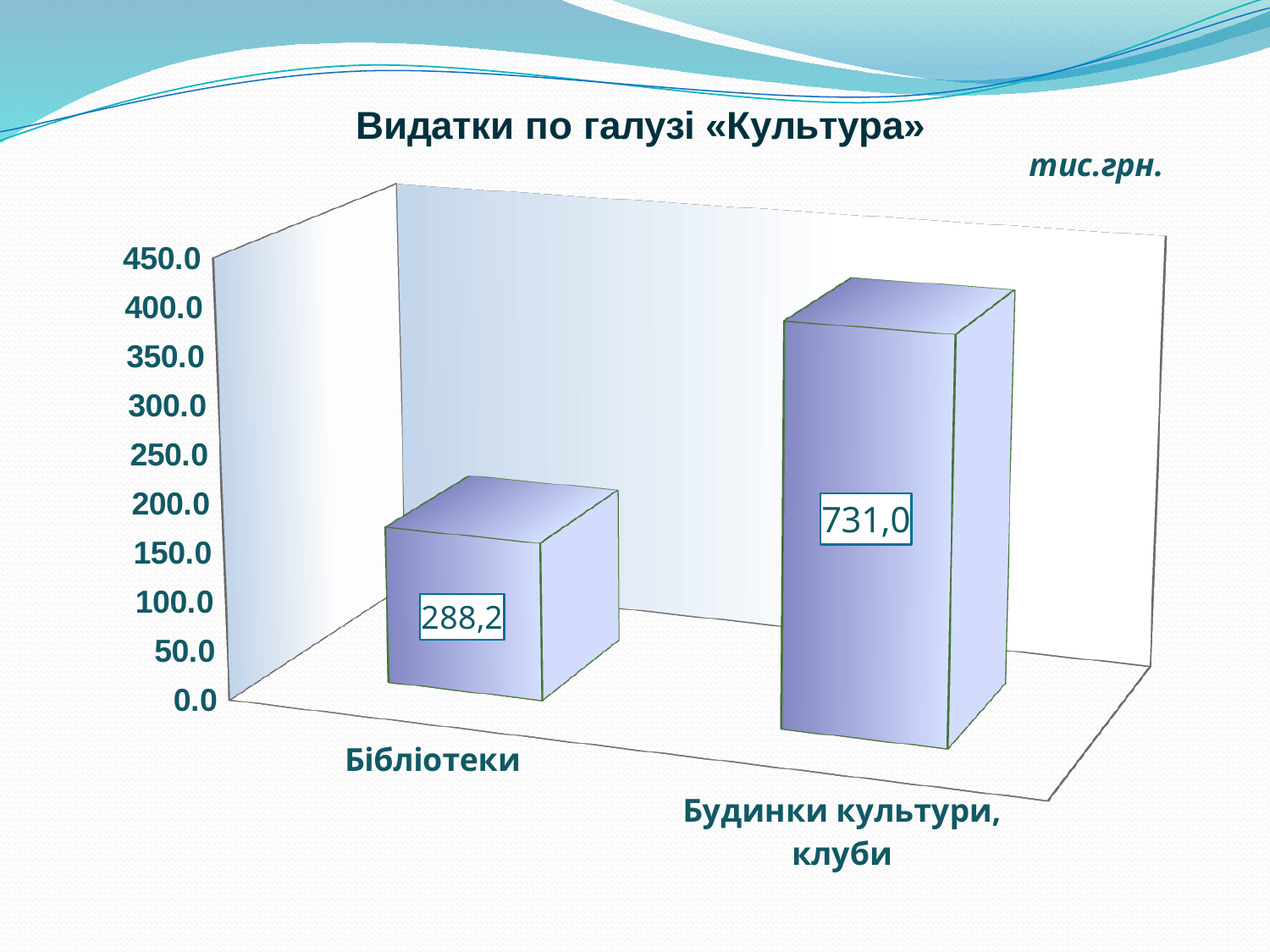
What is the highest tick value shown on the vertical axis? 450.0 What is the value for Будинки культури, клуби? 731,0 How many categories are shown in the chart? 2 Which is larger, the value for Бібліотеки or the value for Будинки культури, клуби? Будинки культури, клуби What is the difference between the values for Будинки культури, клуби and Бібліотеки? 442,8 Which category has the lowest value? Бібліотеки What is the value for Бібліотеки? 288,2 Which category has the highest value? Будинки культури, клуби What is the title of the chart? Видатки по галузі «Культура» What unit is indicated for the chart values? тис.грн. What kind of chart is shown on the slide? Bar chart